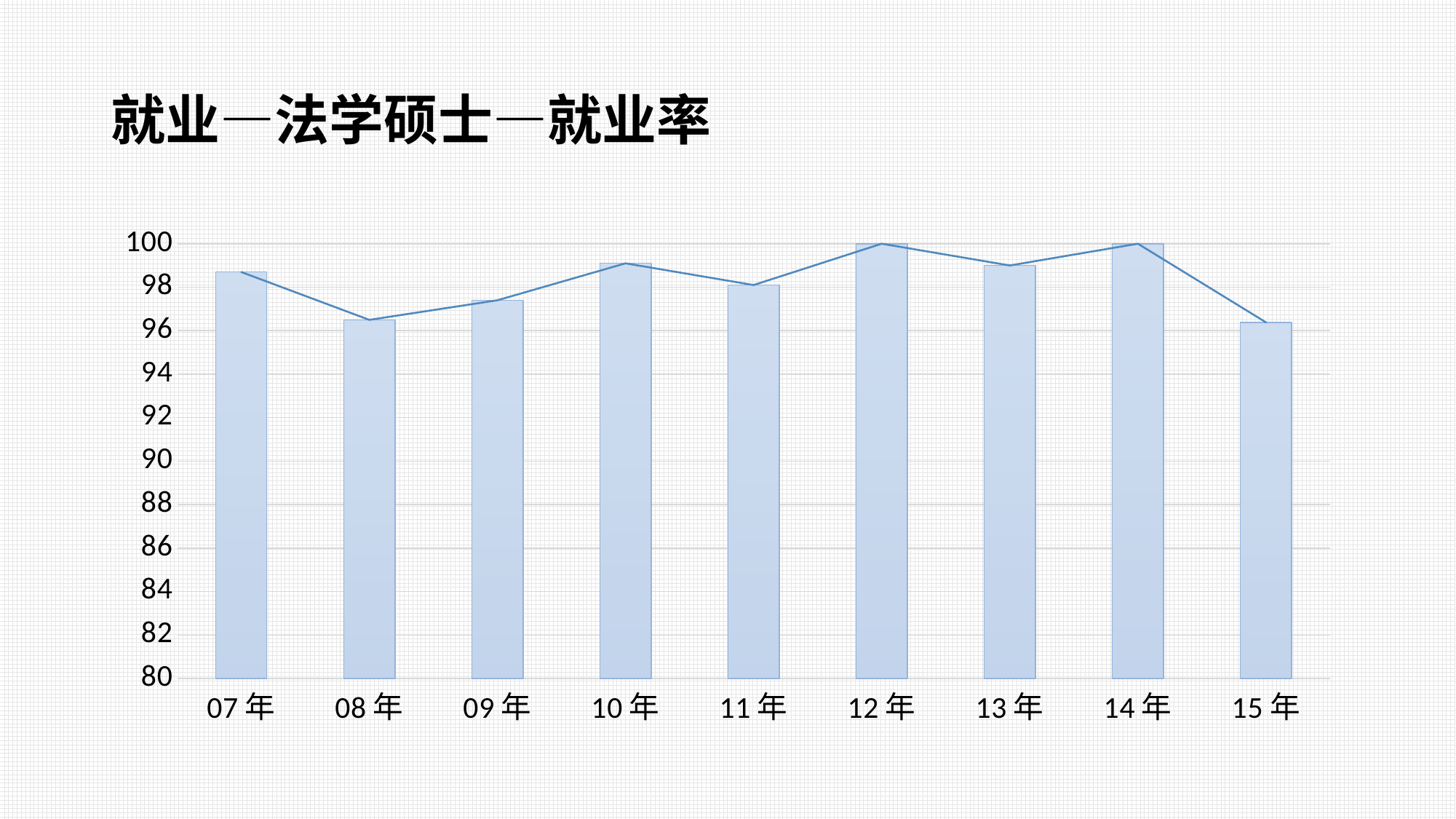
Is the value for 07年 greater or less than 98? greater Is the value for 13年 greater or less than 98? greater What kind of chart is shown on the slide? combination bar and line chart How many years (categories) are shown on the x axis? 9 Is the value for 15年 greater or less than 98? less Which is larger, the value for 10年 or the value for 15年? 10年 What is the value for 12年? 100 What is the value for 14年? 100 Which is larger, the value for 07年 or the value for 08年? 07年 What is the title of the chart on the slide? 就业—法学硕士—就业率 Do the values rise or fall from 08年 to 10年? rise